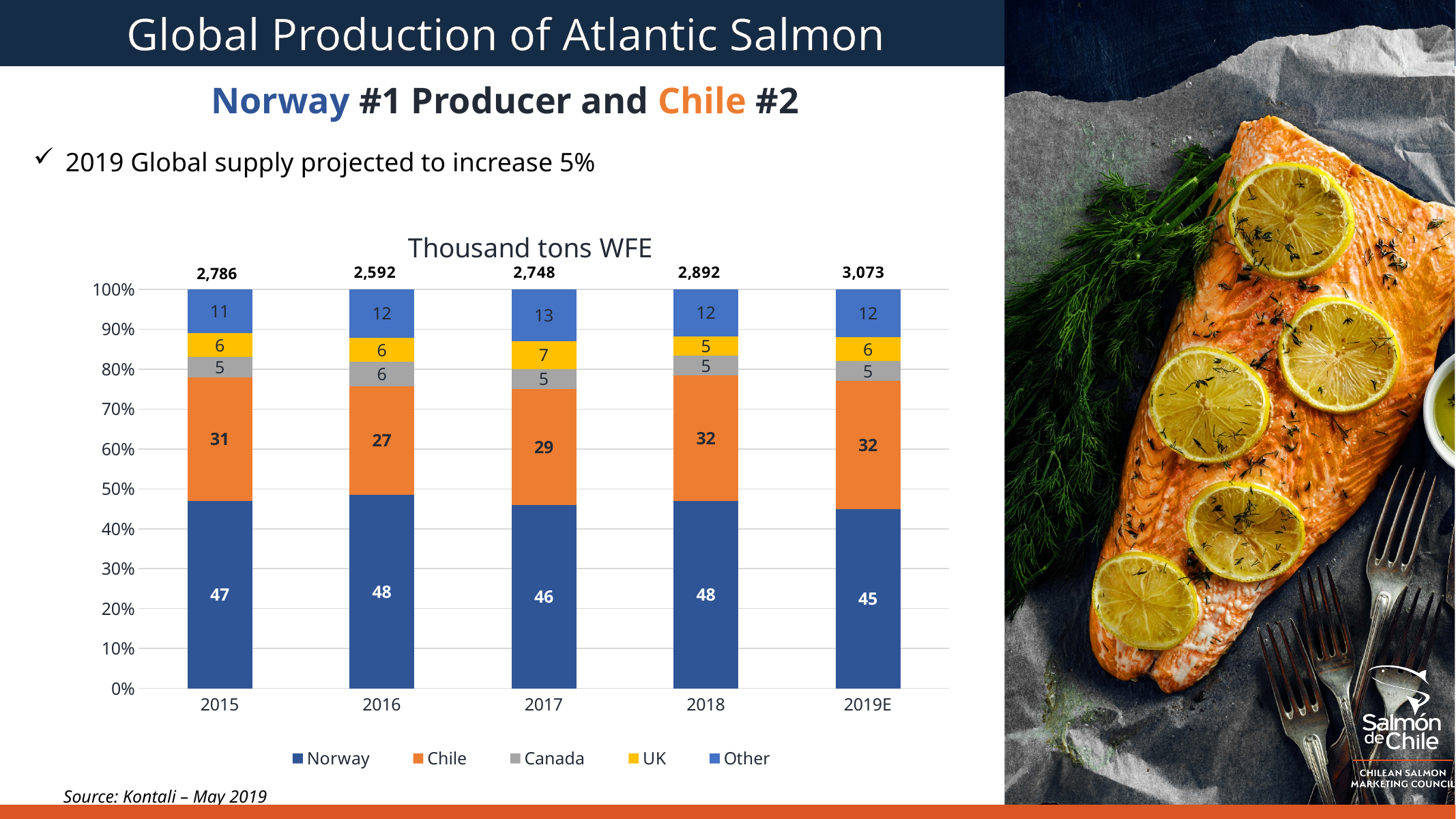
What is the Chile value labelled for 2018? 32 Do the totals printed above the bars rise or fall from 2016 to 2019E? Rise What total is printed above the 2019E bar? 3,073 How many series does the legend list? 5 What is the value for Other in 2017? 13 Which year has the highest total printed above its bar? 2019E How many years are shown on the x axis? 5 In 2015, what is the difference between the Norway value and the Chile value? 16 Is the Chile value larger in 2016 or in 2017? 2017 What kind of chart is shown on the slide? Stacked bar chart What is the Norway share shown for 2017? 46 Which year has the lowest total printed above its bar? 2016